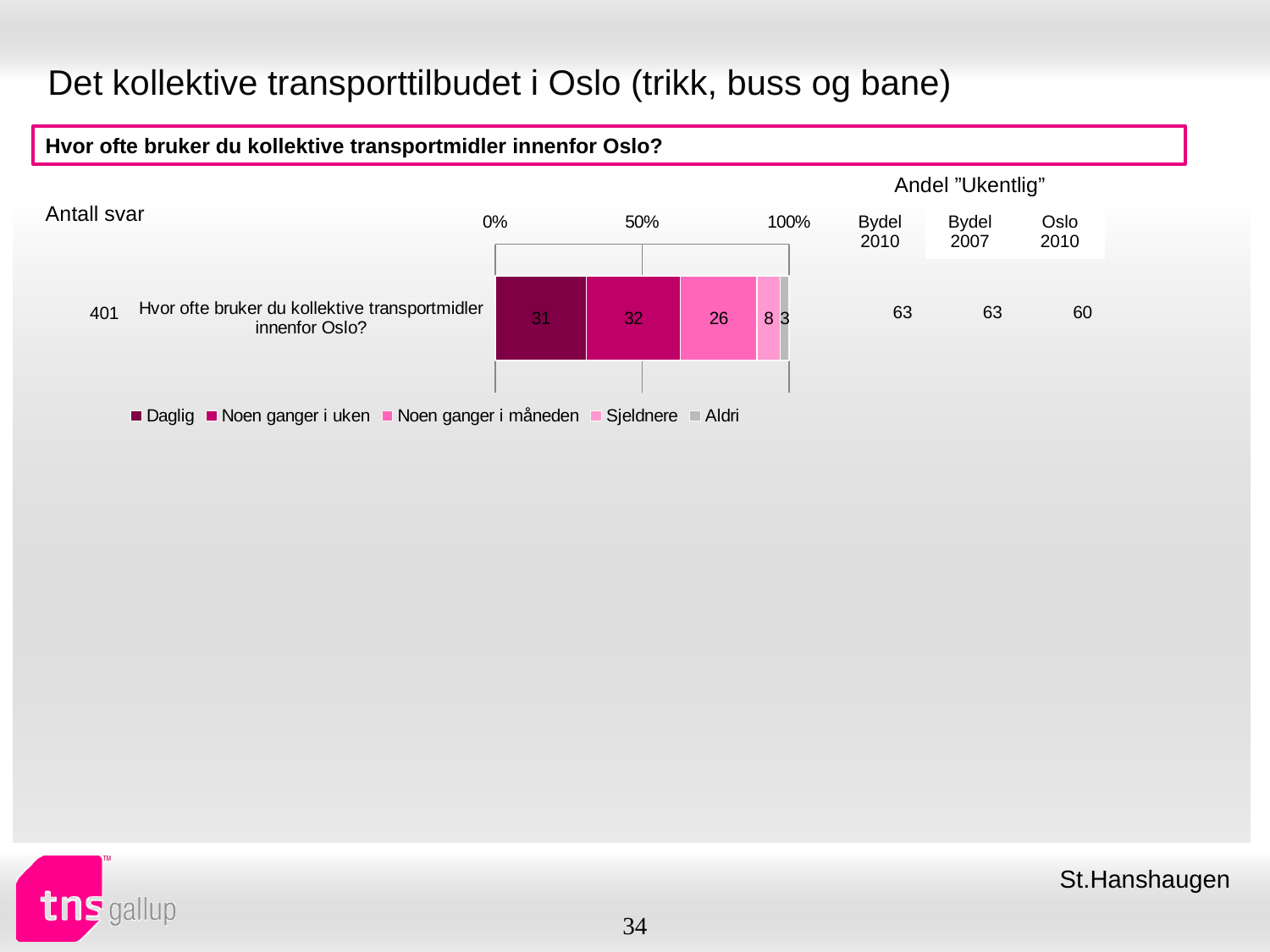
What kind of chart is shown on the slide? Stacked bar chart What is the value for "Noen ganger i måneden" in the stacked bar? 26 Which is larger, the value for "Daglig" or the value for "Noen ganger i måneden"? Daglig Which series has the smallest segment in the stacked bar? Aldri What is the value for "Aldri" in the stacked bar? 3 How many series does the legend list? 5 What is the value for "Noen ganger i uken" in the stacked bar? 32 What is the total of all segments in the stacked bar? 100 What is the value for "Daglig" in the stacked bar? 31 What is the difference between the "Noen ganger i uken" and "Sjeldnere" values? 24 Which series has the largest segment in the stacked bar? Noen ganger i uken What is the value for "Sjeldnere" in the stacked bar? 8